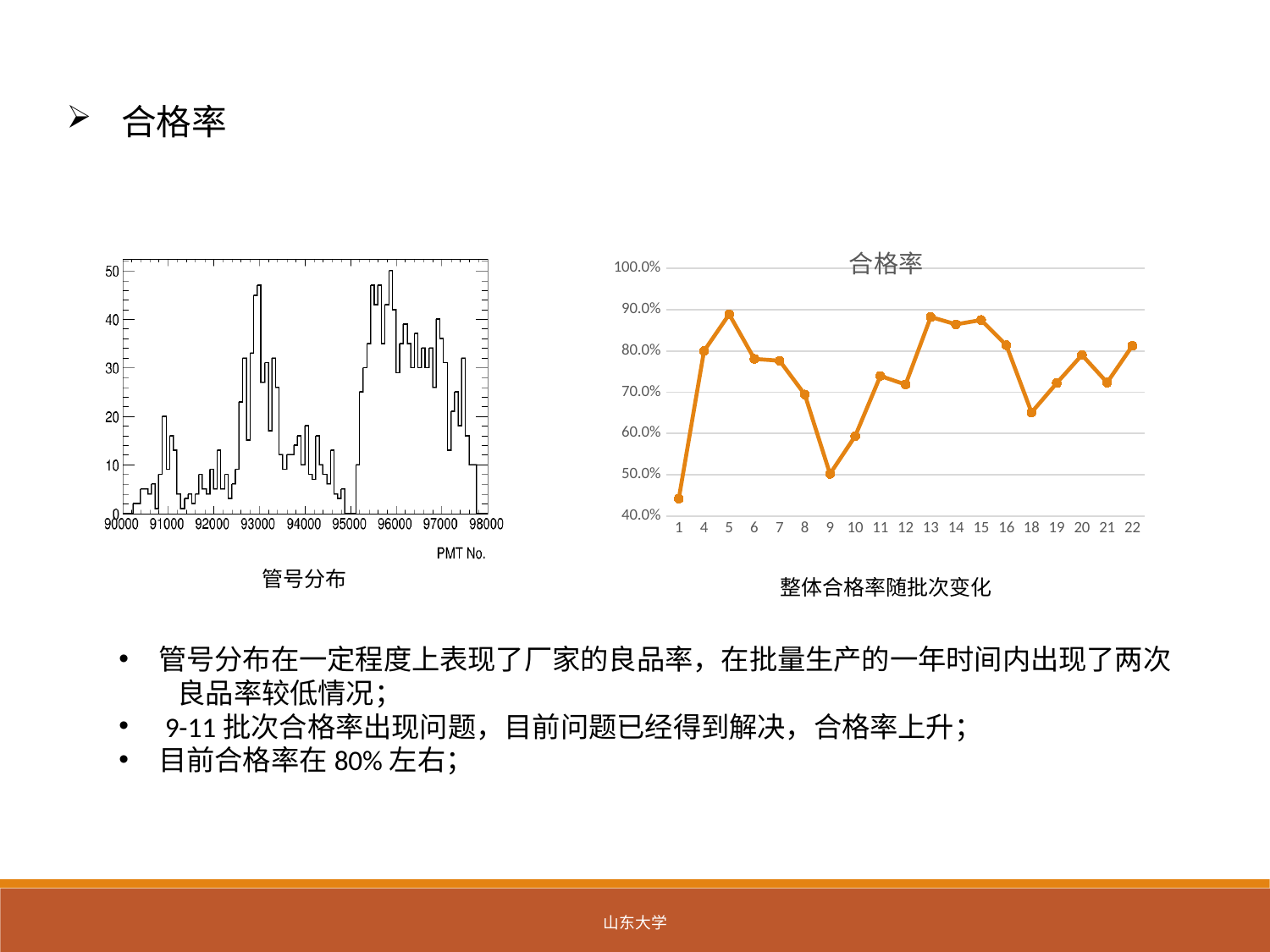
In the right-hand chart titled 合格率, is the value for batch 9 greater or less than 60.0%? less In the right-hand chart titled 合格率, which has the higher pass rate, batch 5 or batch 9? batch 5 What kind of chart is the right-hand chart titled 合格率? line chart In the right-hand chart titled 合格率, does the pass rate rise or fall from batch 9 to batch 13? rise What is the title shown above the right-hand line chart? 合格率 In the right-hand chart titled 合格率, is the value for batch 1 greater or less than 50.0%? less In the right-hand chart titled 合格率, how many batches are plotted along the x axis? 19 In the right-hand chart titled 合格率, which has the higher pass rate, batch 1 or batch 4? batch 4 In the right-hand chart titled 合格率, is the value for batch 18 greater or less than 70.0%? less In the right-hand chart titled 合格率, which batch has the lowest pass rate? 1 What is the x-axis label of the left-hand chart captioned 管号分布? PMT No.